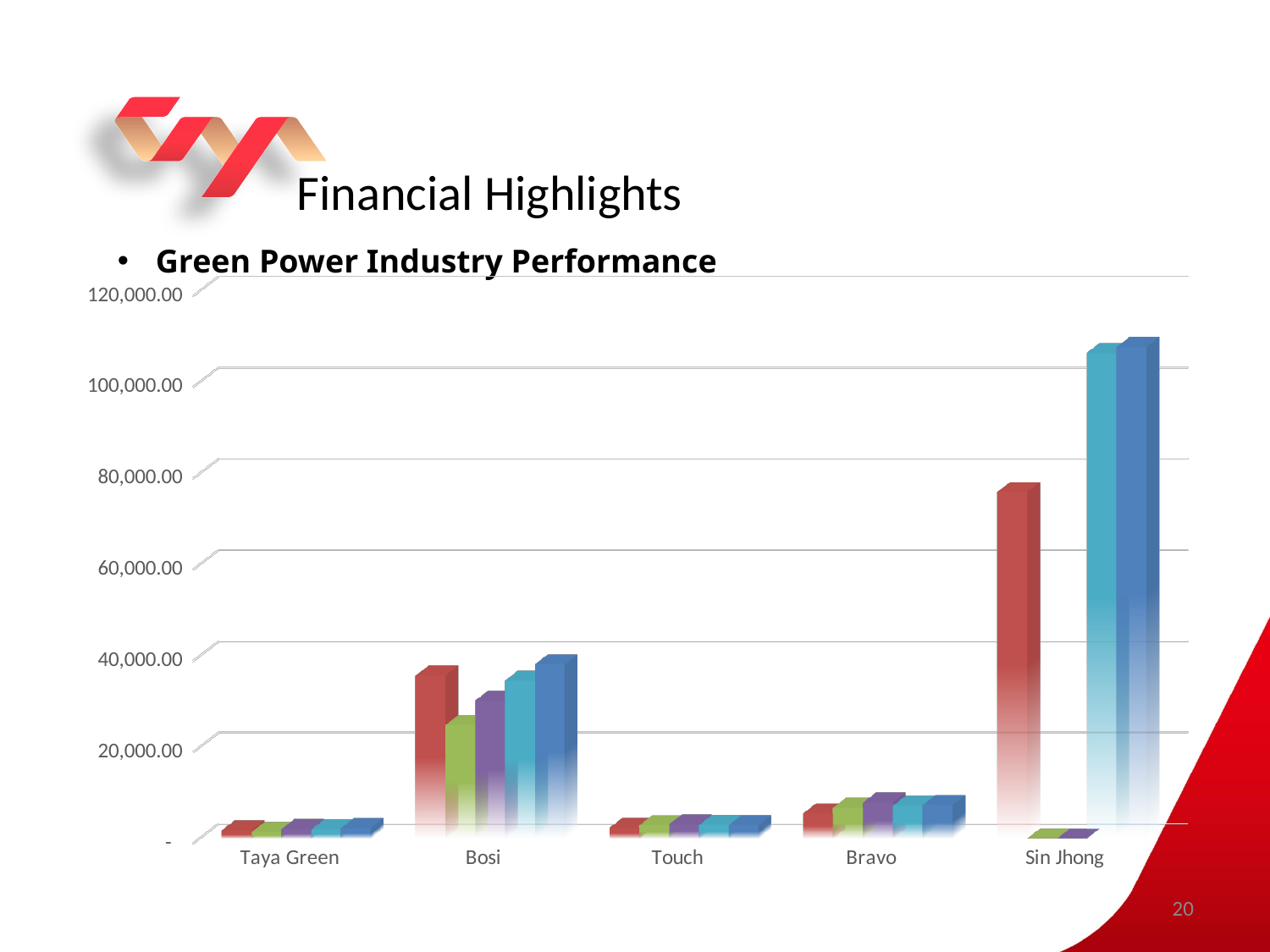
Is the value of the red (first) bar for Bosi greater or less than 40,000.00? less What is the heading given above the chart? Green Power Industry Performance Which has the larger red (first) bar, Sin Jhong or Bosi? Sin Jhong What kind of chart is shown on the slide? bar chart Is the value of the red (first) bar for Sin Jhong greater or less than 80,000.00? less Which has the larger red (first) bar, Bosi or Bravo? Bosi Is the value of the tallest bar for Sin Jhong greater or less than 100,000.00? greater Which category has the tallest bar in the chart? Sin Jhong How many categories are shown on the x axis of the chart? 5